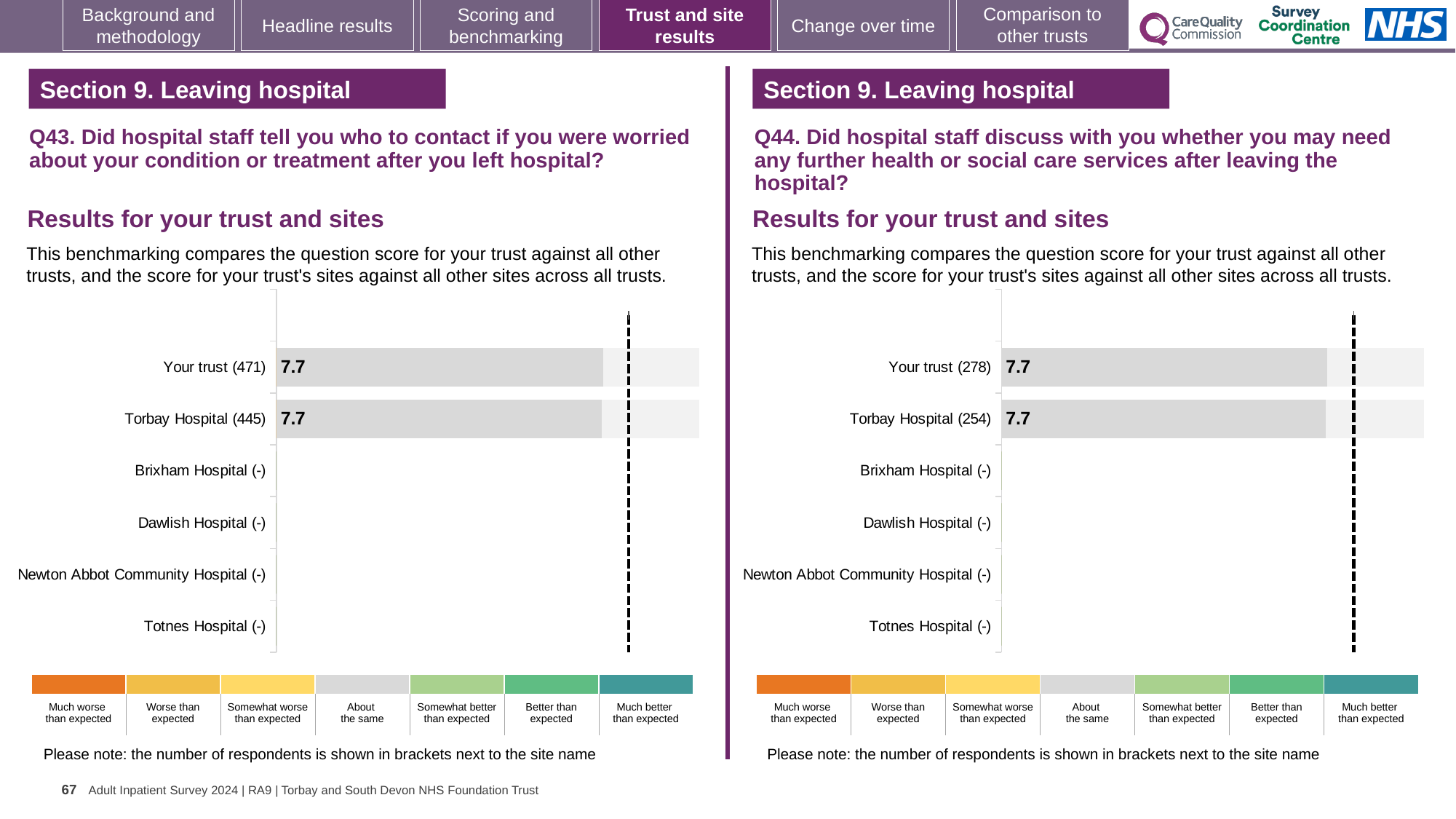
On the Q44 chart (right), how many sites or categories are listed on the vertical axis? 6 On the Q44 chart (right), what is the score for Your trust (278)? 7.7 On the Q44 chart (right), what is the score for Torbay Hospital (254)? 7.7 On the Q44 chart (right), how many sites show a score bar rather than a dash (-)? 2 What kind of chart is the Q43 chart on the left? Bar chart On the Q43 chart (left), what is the score for Torbay Hospital (445)? 7.7 On the Q43 chart (left), how many sites or categories are listed on the vertical axis? 6 On the Q43 chart (left), what is the score for Your trust (471)? 7.7 On the Q44 chart (right), how many respondents are shown in brackets for Your trust? 278 On the Q43 chart (left), what is the difference between the score for Your trust (471) and Torbay Hospital (445)? 0.0 On the Q43 chart (left), which benchmark category does the grey colour of the bars correspond to in the legend? About the same On the Q43 chart (left), how many respondents are shown in brackets for Torbay Hospital? 445